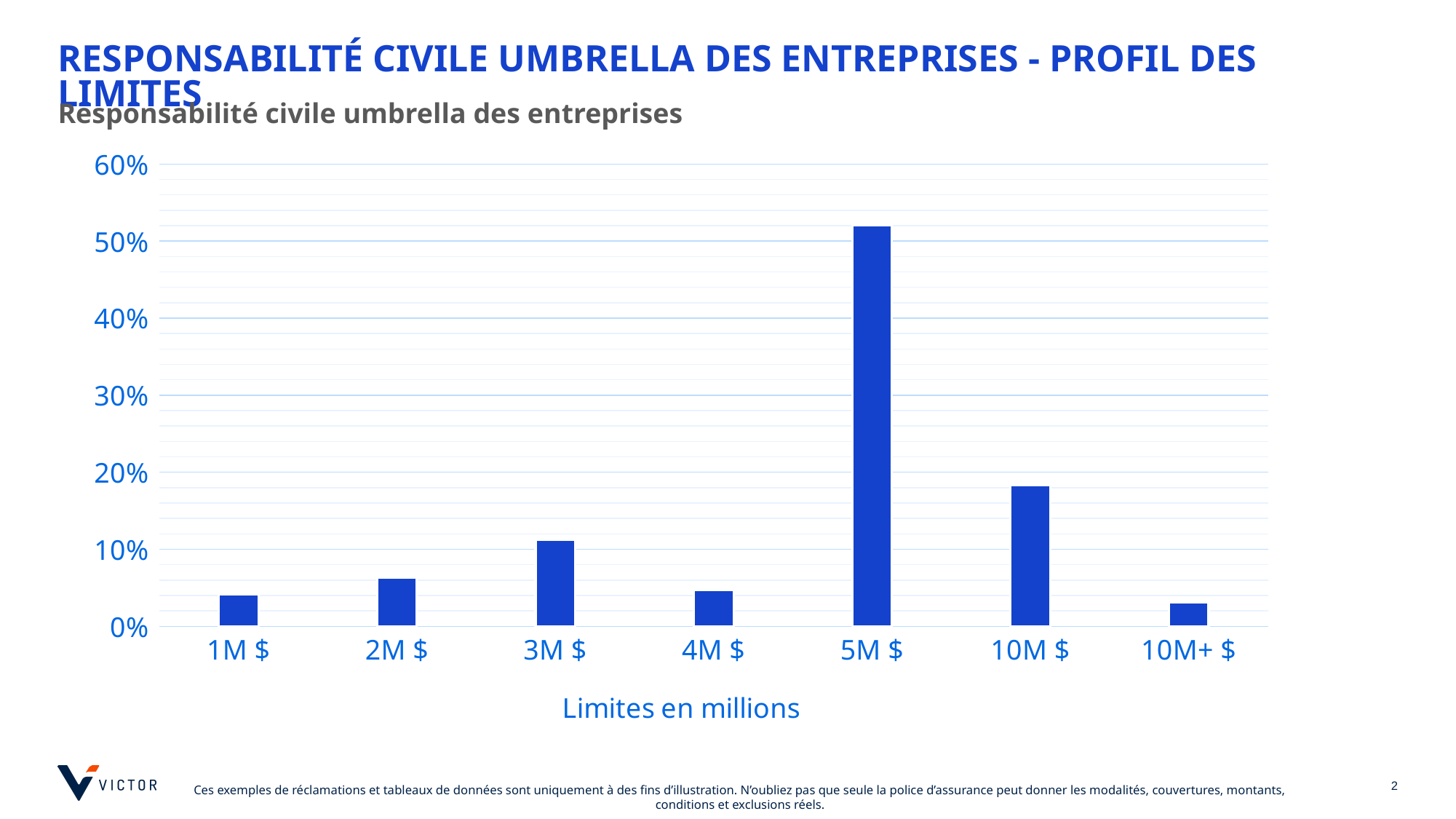
Is the value for 5M $ greater or less than 50%? greater Which limit category has the highest value? 5M $ Is the value for 3M $ greater or less than 10%? greater What is the title of the x axis? Limites en millions Is the value for 10M+ $ greater or less than 10%? less How many limit categories are shown on the x axis? 7 What is the title of the chart? Responsabilité civile umbrella des entreprises What kind of chart is shown on the slide? bar chart Which is larger, the value for 10M $ or the value for 3M $? 10M $ Which is larger, the value for 3M $ or the value for 2M $? 3M $